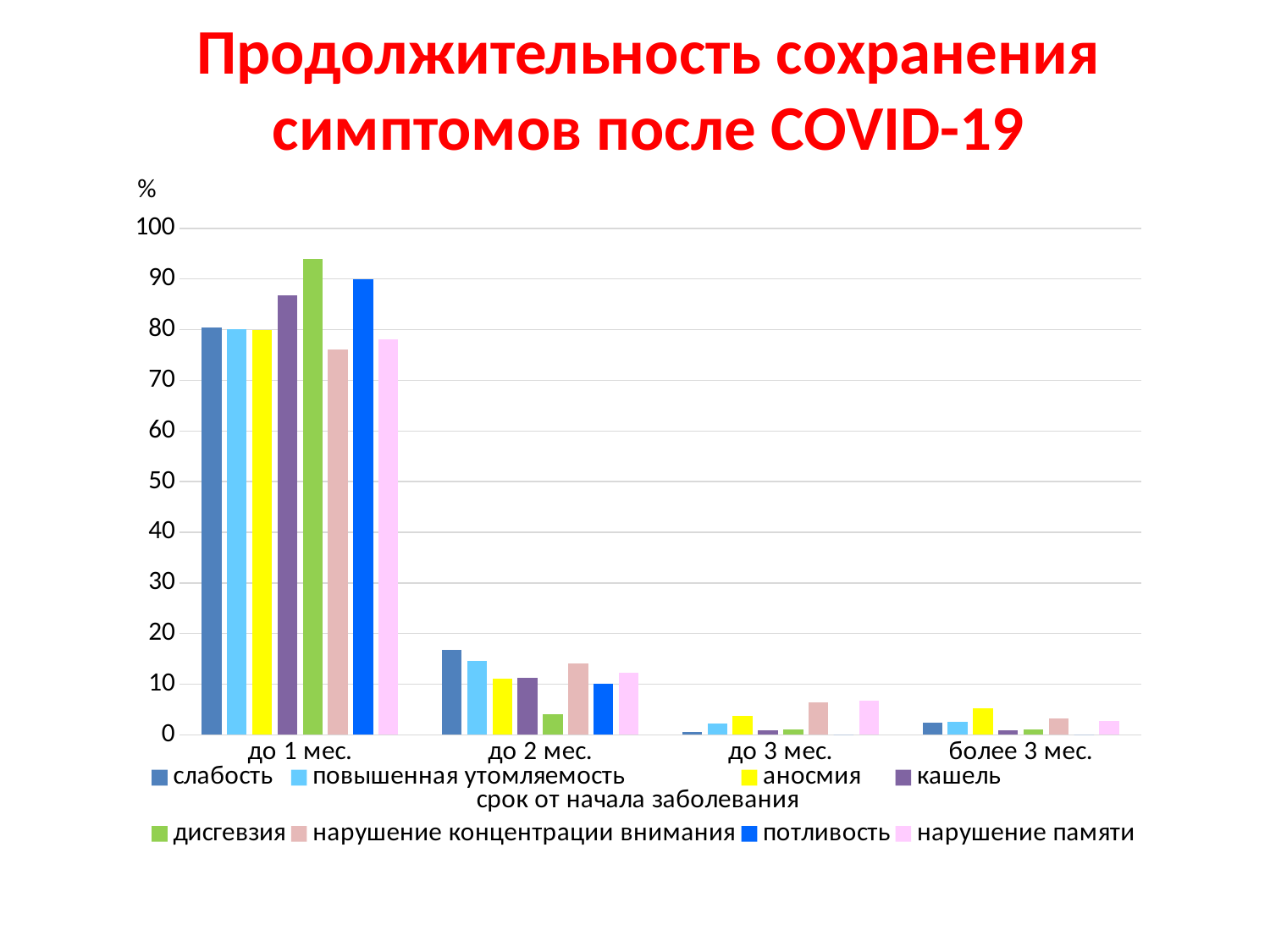
Which symptom has the highest value in the "до 2 мес." category? слабость How many categories are shown along the x axis? 4 What is the label of the x axis? срок от начала заболевания What kind of chart is shown on the slide? bar chart Is the value for "слабость" at "до 2 мес." greater or less than 20? less Do the values for "слабость" rise or fall from "до 1 мес." to "более 3 мес."? fall How many series does the legend list? 8 Is the value for "кашель" at "до 1 мес." greater or less than 80? greater Is the value for "слабость" at "до 1 мес." greater or less than 70? greater Which symptom has the highest value in the "до 1 мес." category? дисгевзия In the "до 2 мес." category, which is larger: "слабость" or "дисгевзия"? слабость